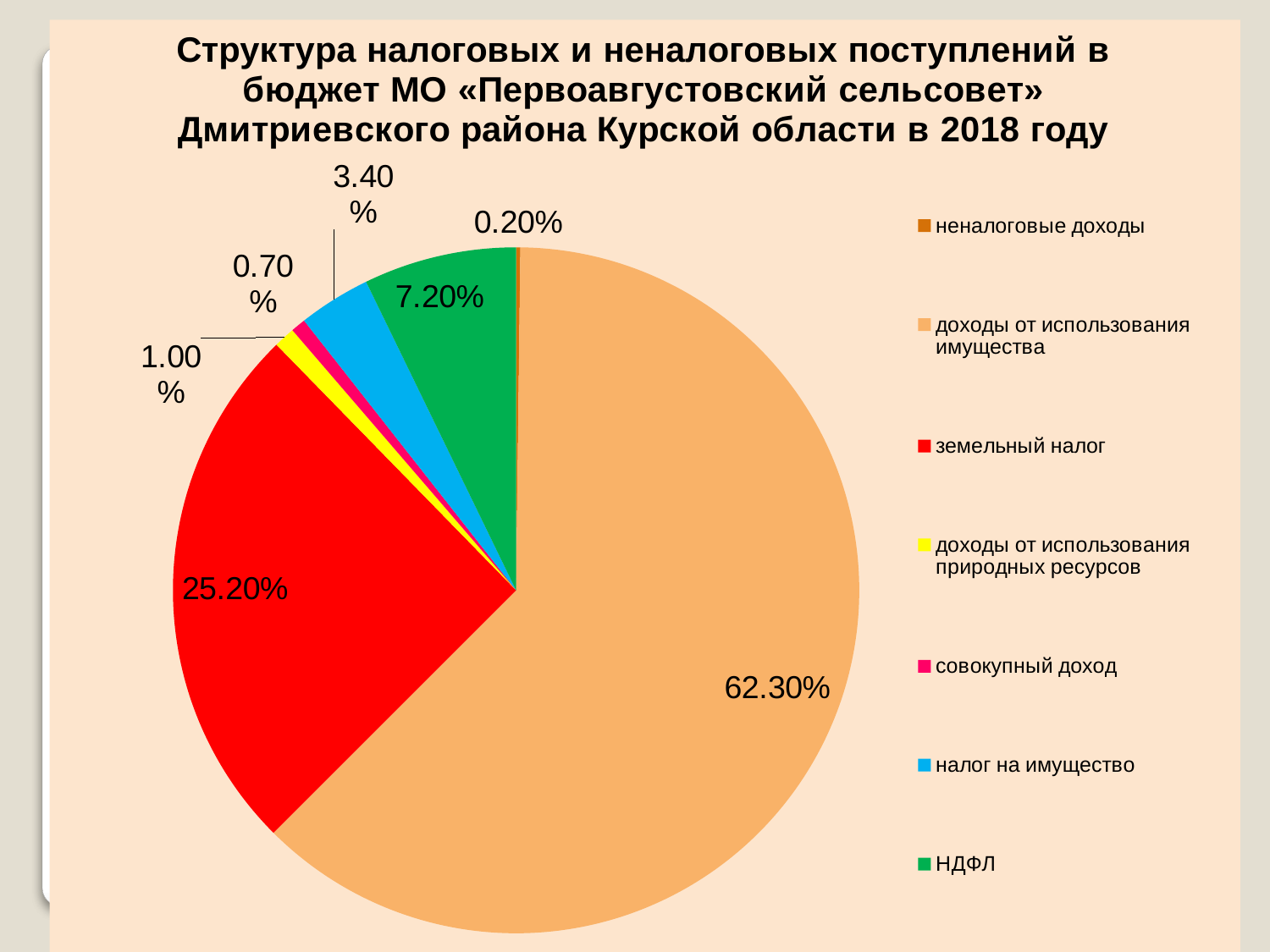
What is the value shown for «неналоговые доходы»? 0.20% How many categories does the legend list? 7 What colour is the slice for «доходы от использования природных ресурсов»? yellow Which category has the smallest slice of the pie? неналоговые доходы What is the difference between the shares of «доходы от использования имущества» and «земельный налог»? 37.10% What is the value shown for «налог на имущество»? 3.40% What is the value shown for «НДФЛ»? 7.20% What share of the pie does «доходы от использования имущества» have? 62.30% What is the value shown for «земельный налог»? 25.20% What type of chart is shown on the slide? pie chart Which is larger: «налог на имущество» or «совокупный доход»? налог на имущество Which category has the largest slice of the pie? доходы от использования имущества